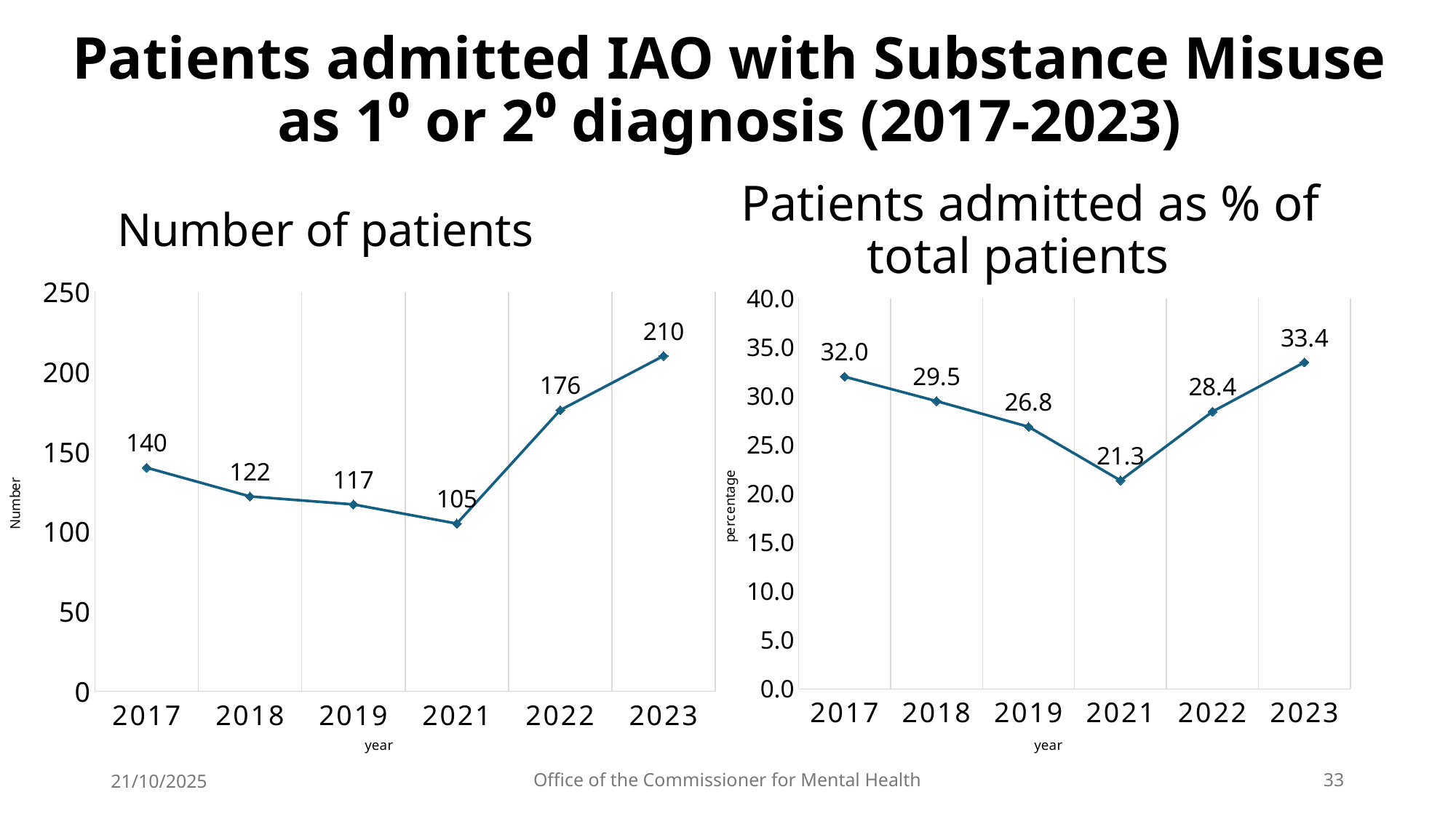
In the 'Number of patients' chart, how many years are plotted on the x axis? 6 In the 'Patients admitted as % of total patients' chart, do the values rise or fall from 2017 to 2021? Fall In the 'Number of patients' chart, what is the difference between the values for 2023 and 2022? 34 What kind of chart is the 'Number of patients' chart? Line chart In the 'Patients admitted as % of total patients' chart, which year has the highest value? 2023 In the 'Patients admitted as % of total patients' chart, is the value for 2017 or 2022 larger? 2017 In the 'Number of patients' chart, which year has the lowest value? 2021 In the 'Patients admitted as % of total patients' chart, which year has the lowest value? 2021 In the 'Patients admitted as % of total patients' chart, what is the value for 2019? 26.8 In the 'Number of patients' chart, which year has the highest value? 2023 What is the y-axis label of the 'Patients admitted as % of total patients' chart? percentage In the 'Number of patients' chart, what is the value for 2021? 105